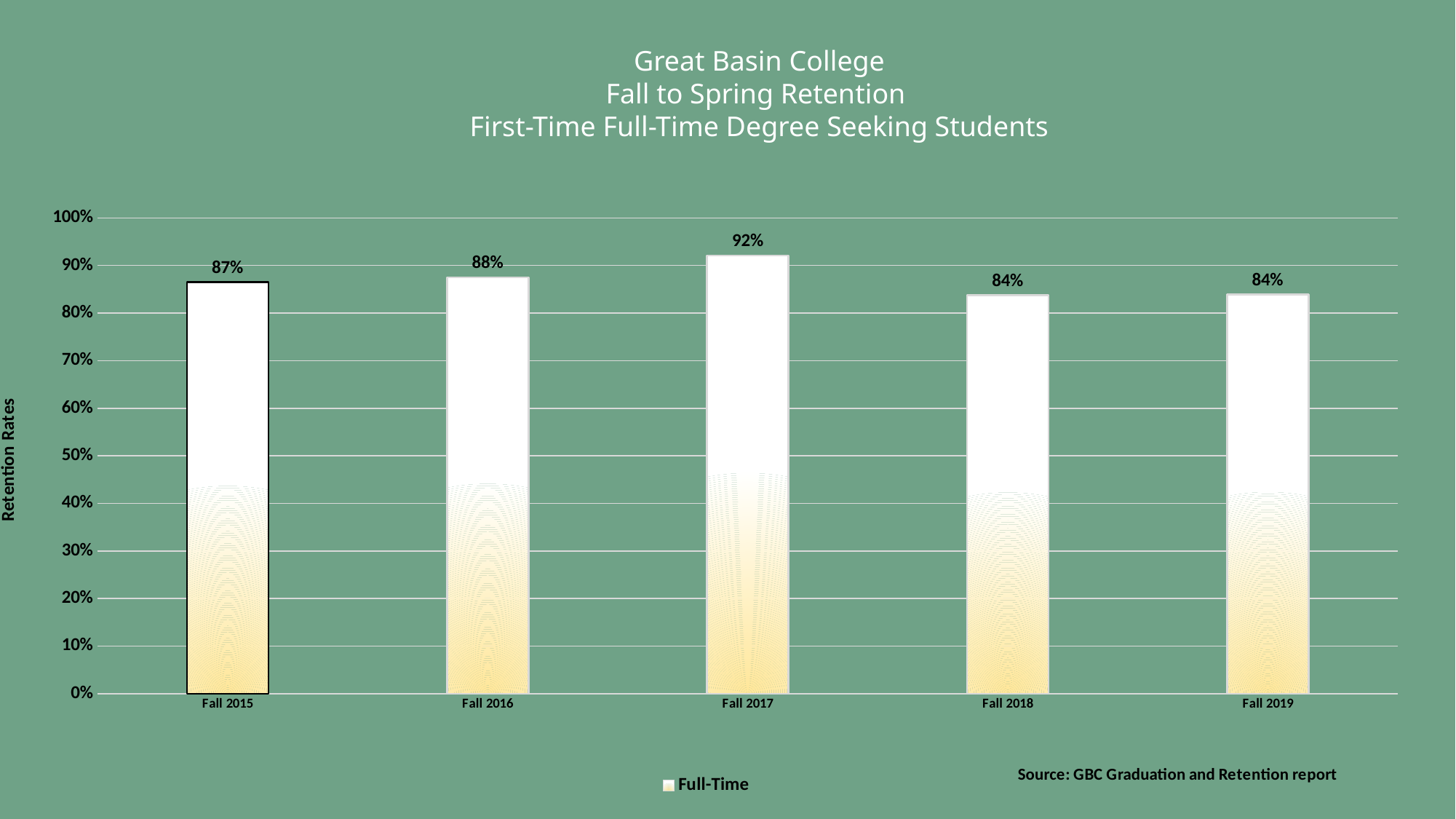
Is the retention rate for Fall 2017 greater or less than 90%? greater What is the difference between the retention rates for Fall 2017 and Fall 2018? 8% What is the difference between the retention rates for Fall 2016 and Fall 2015? 1% What kind of chart is shown on the slide? Bar chart Which is larger, the retention rate for Fall 2016 or for Fall 2019? Fall 2016 How many series does the legend list? 1 What is the retention rate for Fall 2019? 84% What is the label on the vertical axis? Retention Rates What is the retention rate for Fall 2015? 87% Which fall term has the highest retention rate? Fall 2017 What is the retention rate for Fall 2017? 92% How many fall terms are shown on the chart? 5